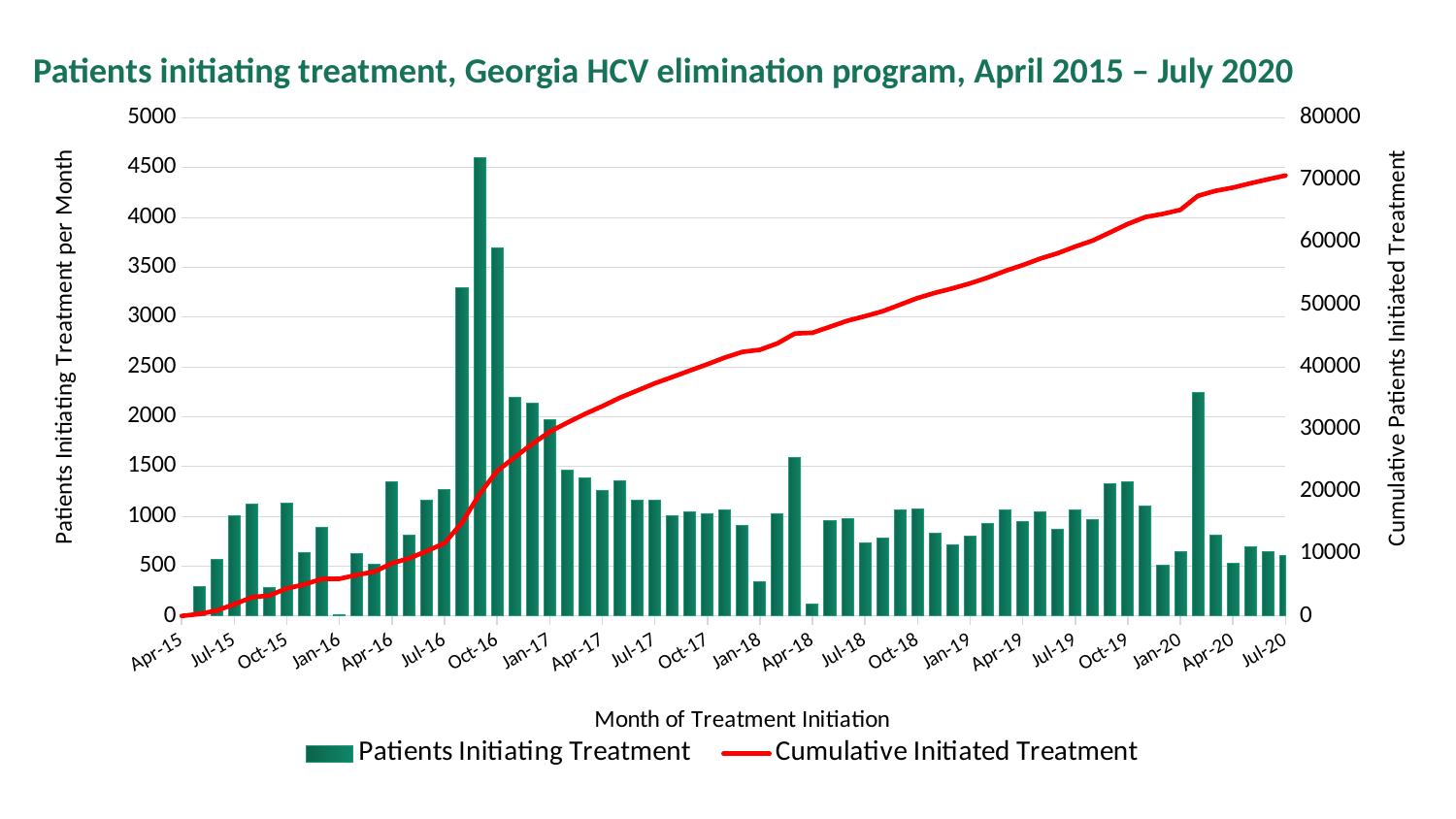
Is the Cumulative Initiated Treatment value at Apr-15 greater or less than 10000? less How many month labels are shown along the x axis? 22 What is the title of the chart? Patients initiating treatment, Georgia HCV elimination program, April 2015 – July 2020 Is the tallest Patients Initiating Treatment bar greater or less than 4000? greater Is the Patients Initiating Treatment bar for Apr-15 greater or less than 500? less In which year does the tallest Patients Initiating Treatment bar occur? 2016 What kind of chart is shown on the slide? A combined bar and line chart What is the maximum value shown on the right-hand (cumulative) axis? 80000 What are the two series named in the legend? Patients Initiating Treatment; Cumulative Initiated Treatment How many series does the legend list? 2 Does the Cumulative Initiated Treatment line rise or fall from Apr-15 to Jul-20? Rises